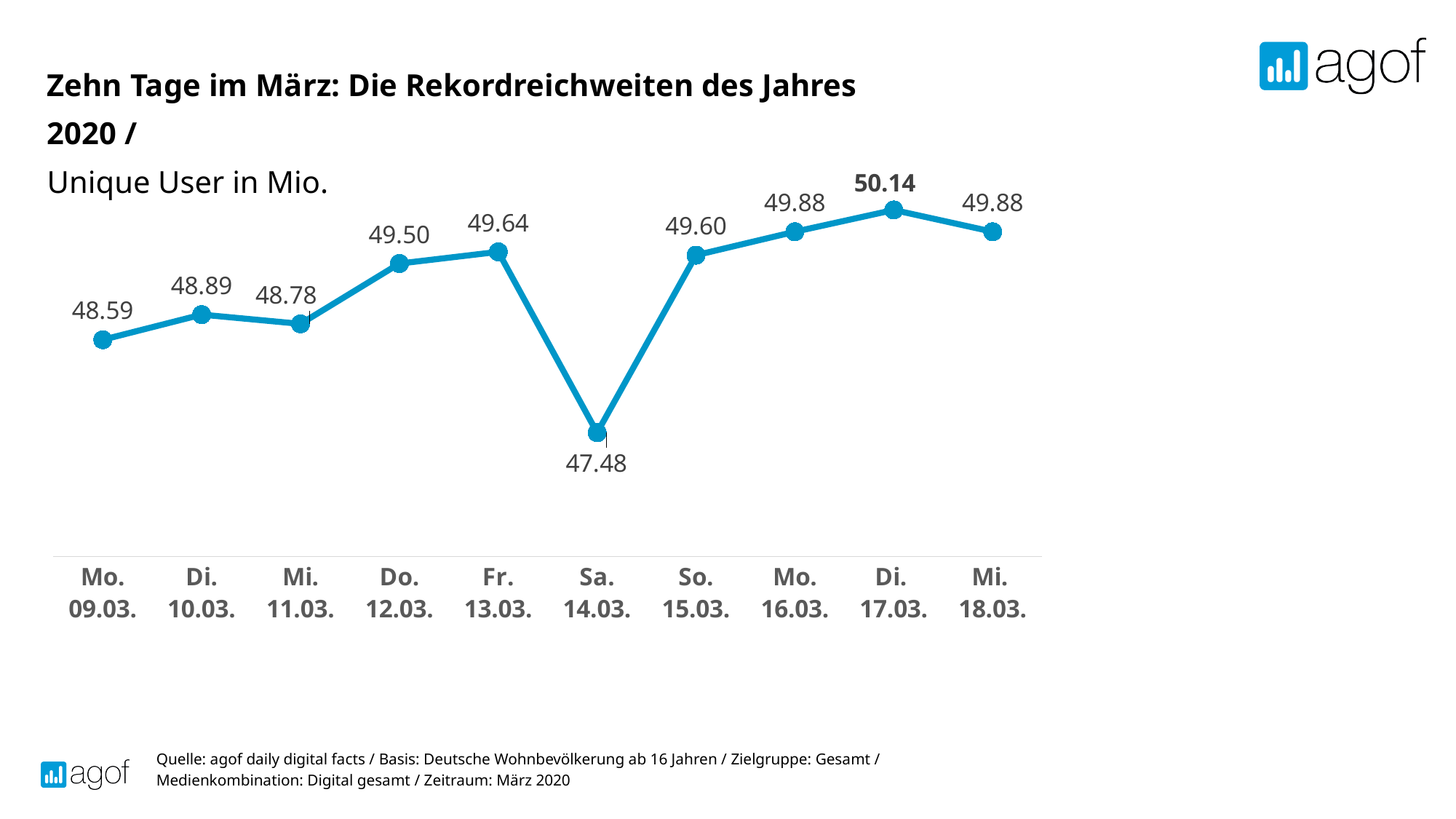
What unit are the values on the chart given in? Unique User in Mio. What is the value for Di. 17.03.? 50.14 What is the difference between the values for Di. 17.03. and Sa. 14.03.? 2.66 Which is larger, the value for Di. 10.03. or the value for Mi. 11.03.? Di. 10.03. What is the value for Fr. 13.03.? 49.64 What is the value for Sa. 14.03.? 47.48 Which day has the lowest value? Sa. 14.03. What is the value for Mo. 09.03.? 48.59 Which day has the highest value? Di. 17.03. What is the difference between the values for Do. 12.03. and Mi. 11.03.? 0.72 What kind of chart is shown on the slide? line chart How many data points are plotted on the chart? 10